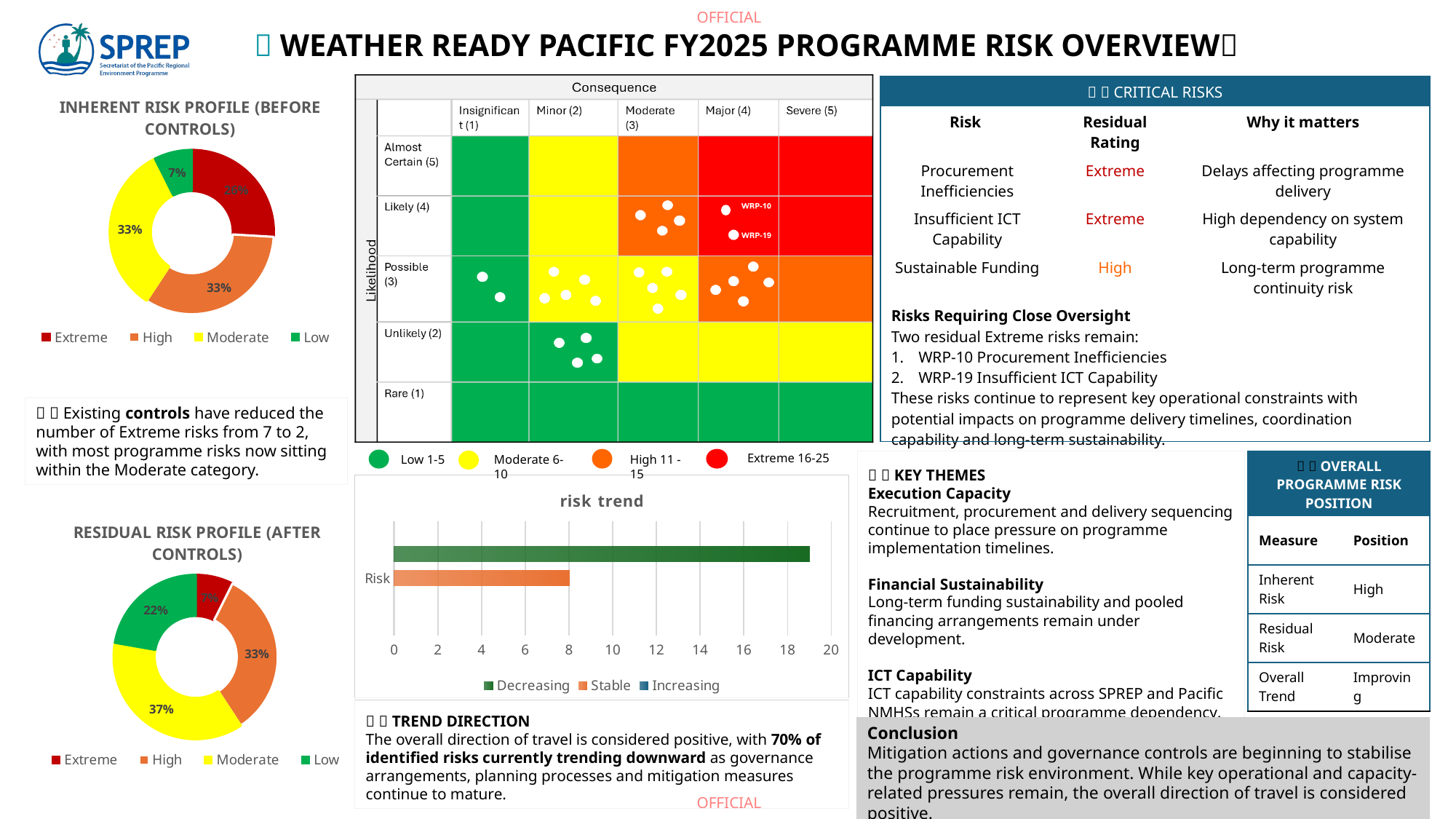
In the Residual Risk Profile (After Controls) donut chart, which category has the smallest share? Extreme In the 'risk trend' chart, is the value for Decreasing greater or less than 16? greater In the Inherent Risk Profile (Before Controls) donut chart, what share is Low? 7% In the Residual Risk Profile (After Controls) donut chart, what share is Moderate? 37% In the Residual Risk Profile (After Controls) donut chart, which category has the largest share? Moderate What kind of chart is the 'risk trend' chart? Bar chart How many categories does the legend of the Inherent Risk Profile (Before Controls) chart list? 4 In the Inherent Risk Profile (Before Controls) donut chart, what share is High? 33% In the Residual Risk Profile (After Controls) donut chart, what share is Extreme? 7% In the Residual Risk Profile (After Controls) donut chart, what share is Low? 22% How many series does the legend of the 'risk trend' chart list? 3 In the Residual Risk Profile (After Controls) donut chart, what is the difference in percentage points between Moderate and Low? 15 percentage points